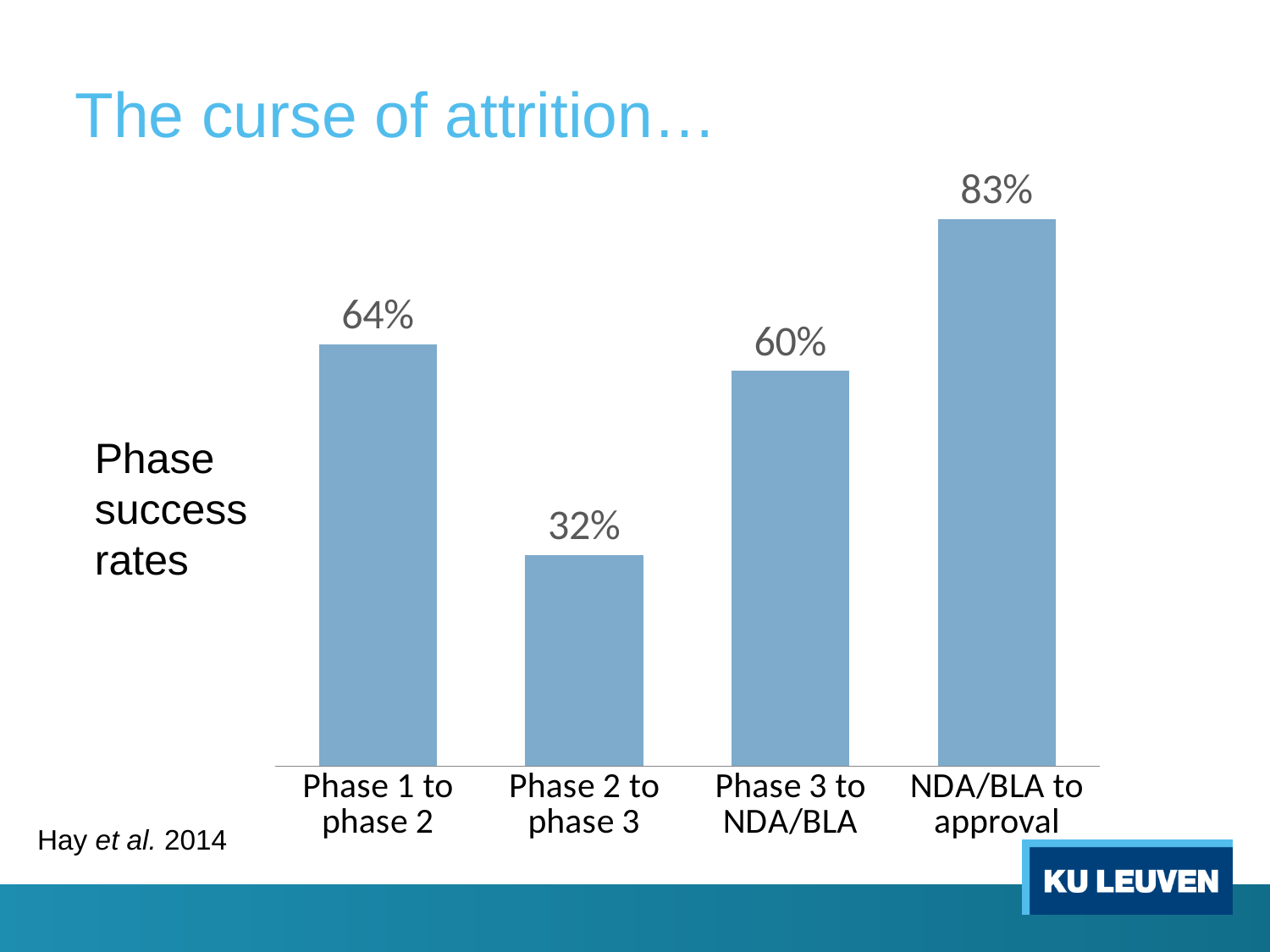
What is the difference between the success rates for Phase 1 to phase 2 and Phase 3 to NDA/BLA? 4% What is the phase success rate for Phase 2 to phase 3? 32% How many phase transitions are shown in the chart? 4 Which transition has the lowest phase success rate? Phase 2 to phase 3 What is the title of the slide containing the chart? The curse of attrition… Which transition has the highest phase success rate? NDA/BLA to approval Which has a higher success rate: Phase 1 to phase 2 or Phase 2 to phase 3? Phase 1 to phase 2 What is the difference between the success rates for NDA/BLA to approval and Phase 2 to phase 3? 51% What kind of chart is shown on the slide? Bar chart What is the phase success rate for Phase 3 to NDA/BLA? 60% What is the phase success rate for NDA/BLA to approval? 83% What is the phase success rate for Phase 1 to phase 2? 64%